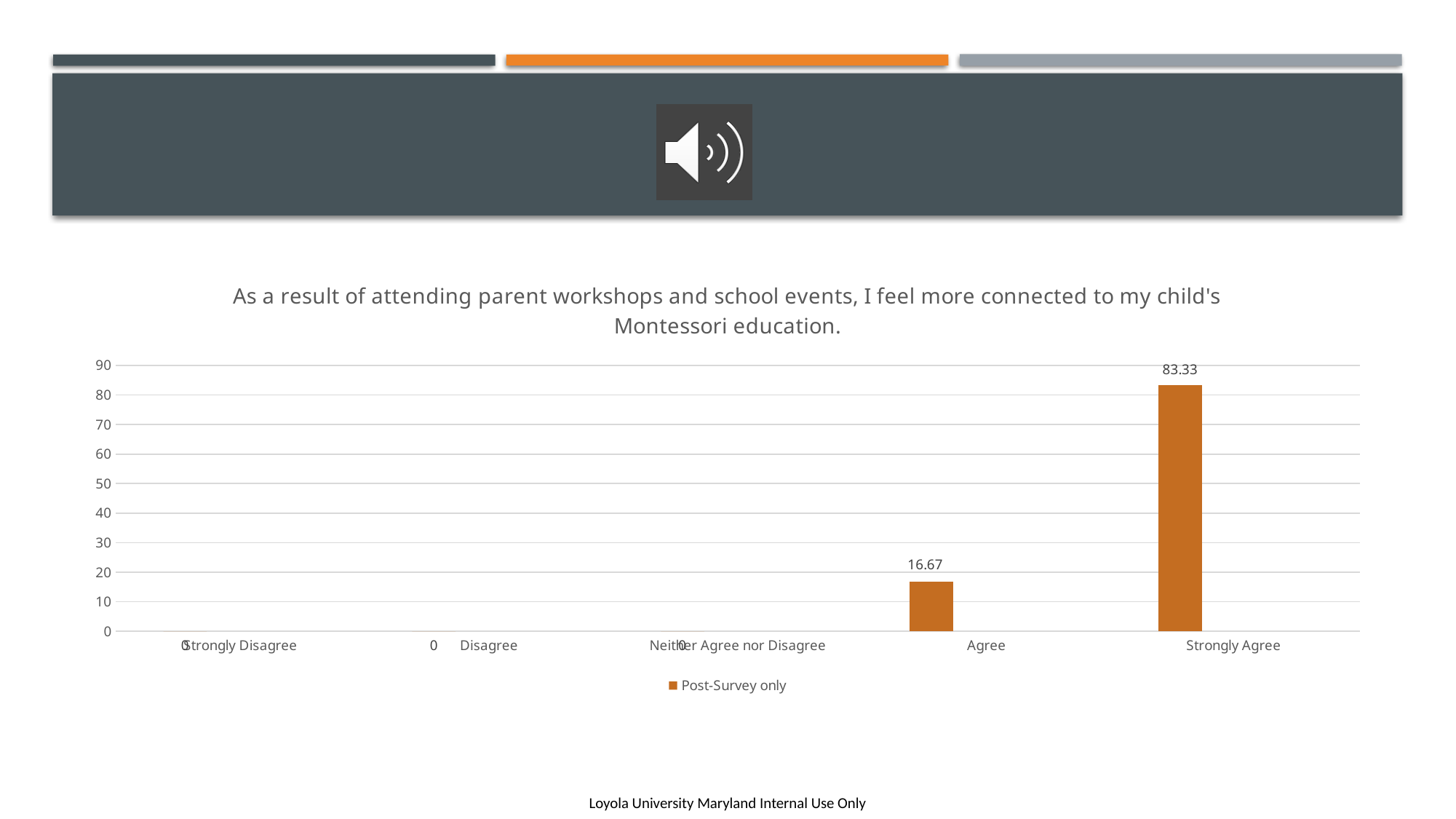
What is the value for Strongly Agree? 83.33 Which is larger, the value for Agree or the value for Strongly Agree? Strongly Agree Which category has the highest value? Strongly Agree What is the value for Disagree? 0 What is the value for Agree? 16.67 What kind of chart is shown on the slide? bar chart Is the value for Agree greater or less than 20? less How many series does the legend list? 1 How many categories are shown on the x axis? 5 What is the difference between the values for Strongly Agree and Agree? 66.66 Is the value for Strongly Agree greater or less than 80? greater What is the name of the series in the legend? Post-Survey only